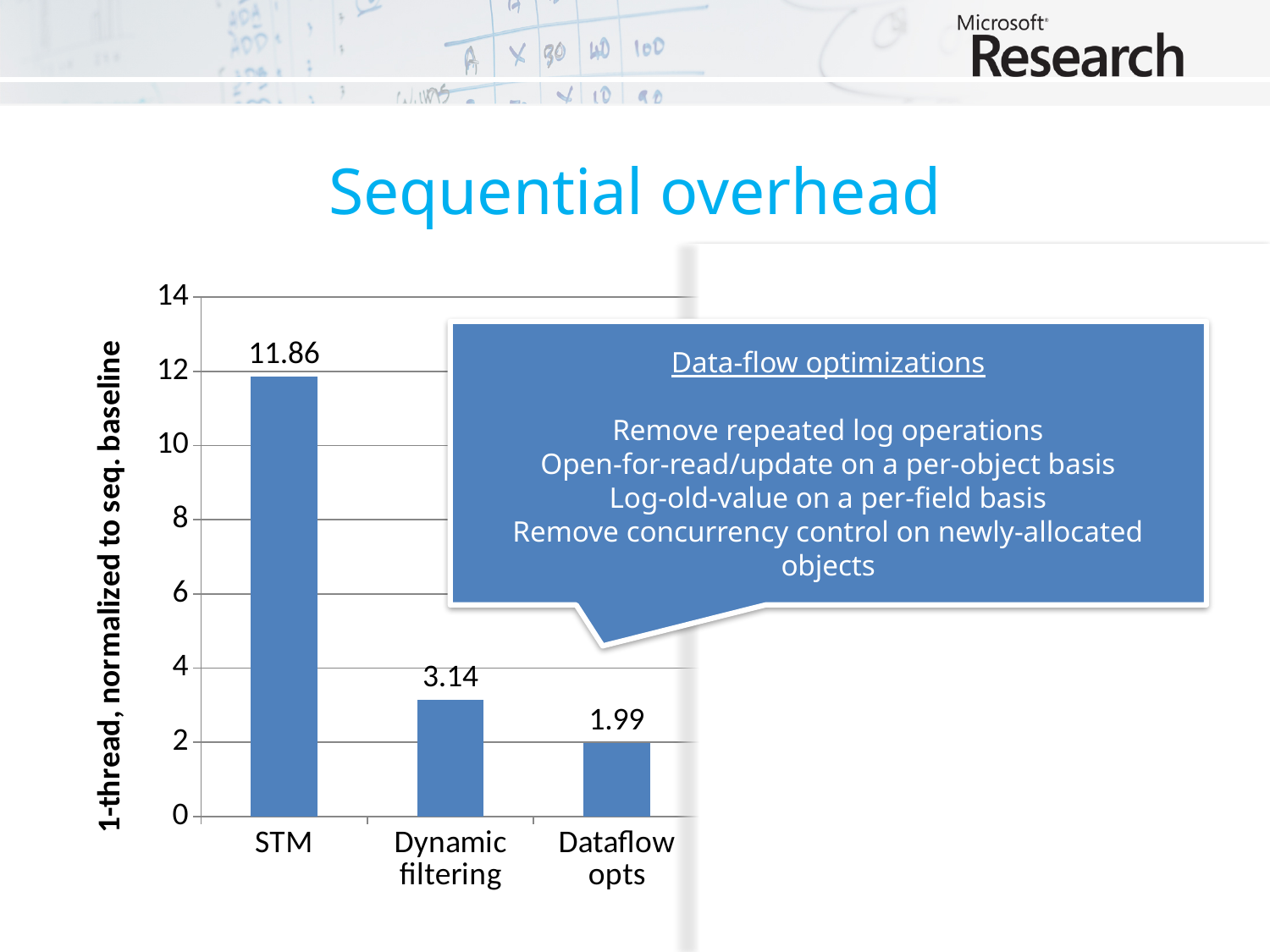
What kind of chart is shown on the slide? Bar chart What is the difference between the values for STM and Dynamic filtering? 8.72 What is the value for Dataflow opts? 1.99 What is the value for Dynamic filtering? 3.14 Do the values fall or rise going from STM to Dynamic filtering to Dataflow opts along the x axis? Fall Of the three labeled bars (STM, Dynamic filtering, Dataflow opts), which has the highest value? STM What is the label on the vertical axis of the chart? 1-thread, normalized to seq. baseline Which is larger, the value for Dynamic filtering or the value for Dataflow opts? Dynamic filtering What is the value for STM? 11.86 What is the difference between the values for Dynamic filtering and Dataflow opts? 1.15 Of the three labeled bars (STM, Dynamic filtering, Dataflow opts), which has the lowest value? Dataflow opts Is the value for STM greater or less than 10? greater